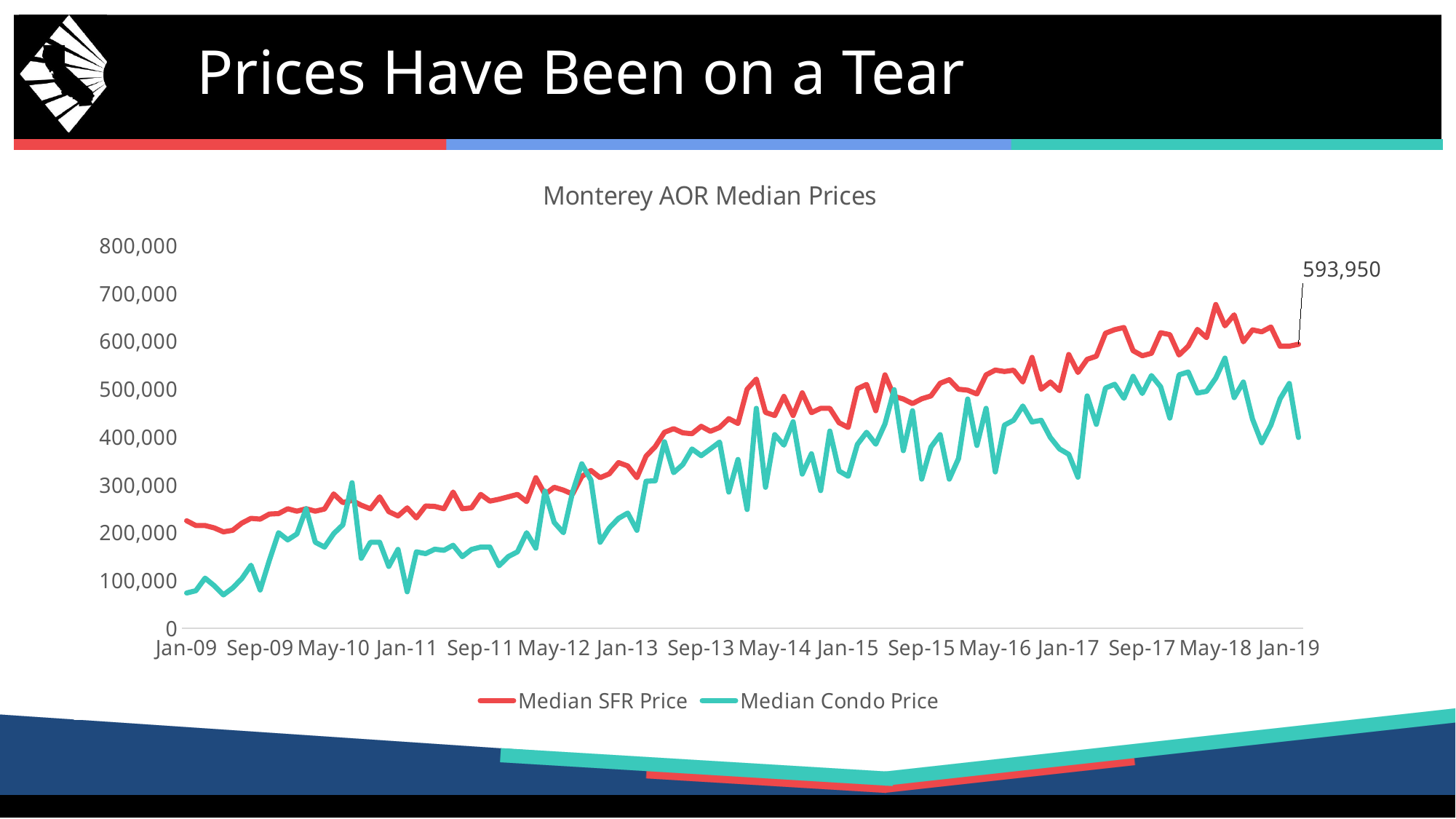
Is the Median Condo Price at Jan-09 greater or less than 100,000? less How many series does the legend list? 2 Which series stays above the other for almost the entire period? Median SFR Price At Jan-09, which is higher: the Median SFR Price or the Median Condo Price? Median SFR Price Does the Median SFR Price generally rise or fall from Jan-09 to Jan-19? Rise Is the final labelled Median SFR Price (593,950) greater or less than 600,000? less What is the labelled value of the Median SFR Price at the end of the series (Jan-19)? 593,950 What is the title of the chart? Monterey AOR Median Prices Is the Median SFR Price at Jan-09 greater or less than 200,000? greater What colour is the Median Condo Price line? Teal What kind of chart is shown on the slide? Line chart